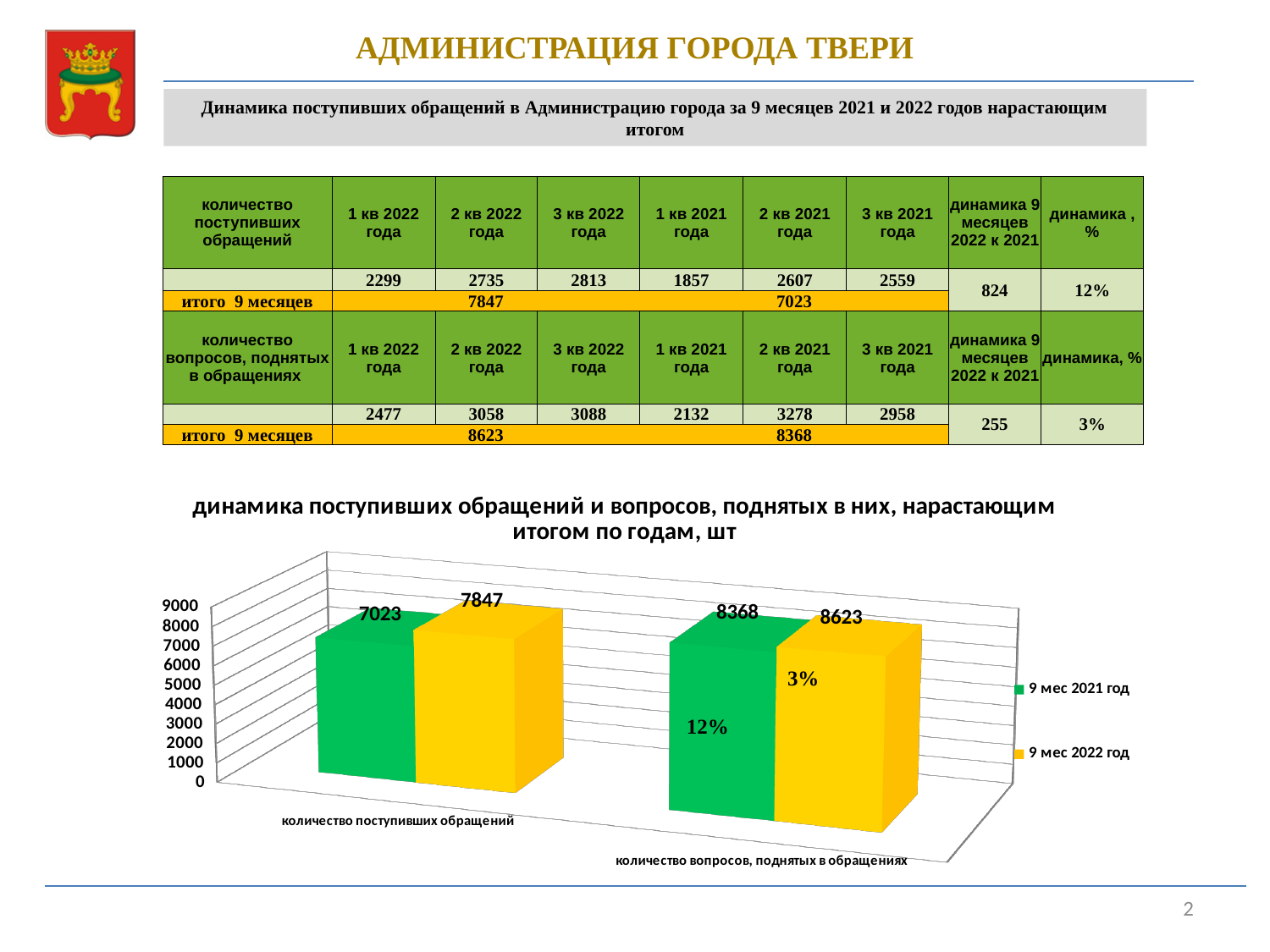
How many series does the legend list? 2 What kind of chart is shown on the slide? bar chart Is the value for "9 мес 2021 год" in "количество поступивших обращений" greater or less than 8000? less What is the value for "9 мес 2022 год" in the "количество поступивших обращений" category? 7847 Which category has the highest value for the "9 мес 2022 год" series? количество вопросов, поднятых в обращениях What is the difference between the 2022 and 2021 values for "количество поступивших обращений"? 824 Which series has the larger value in the "количество поступивших обращений" category, "9 мес 2021 год" or "9 мес 2022 год"? 9 мес 2022 год How many categories are shown on the x axis? 2 What is the value for "9 мес 2021 год" in the "количество поступивших обращений" category? 7023 What is the value for "9 мес 2022 год" in the "количество вопросов, поднятых в обращениях" category? 8623 What is the difference between the 2022 and 2021 values for "количество вопросов, поднятых в обращениях"? 255 What is the value for "9 мес 2021 год" in the "количество вопросов, поднятых в обращениях" category? 8368